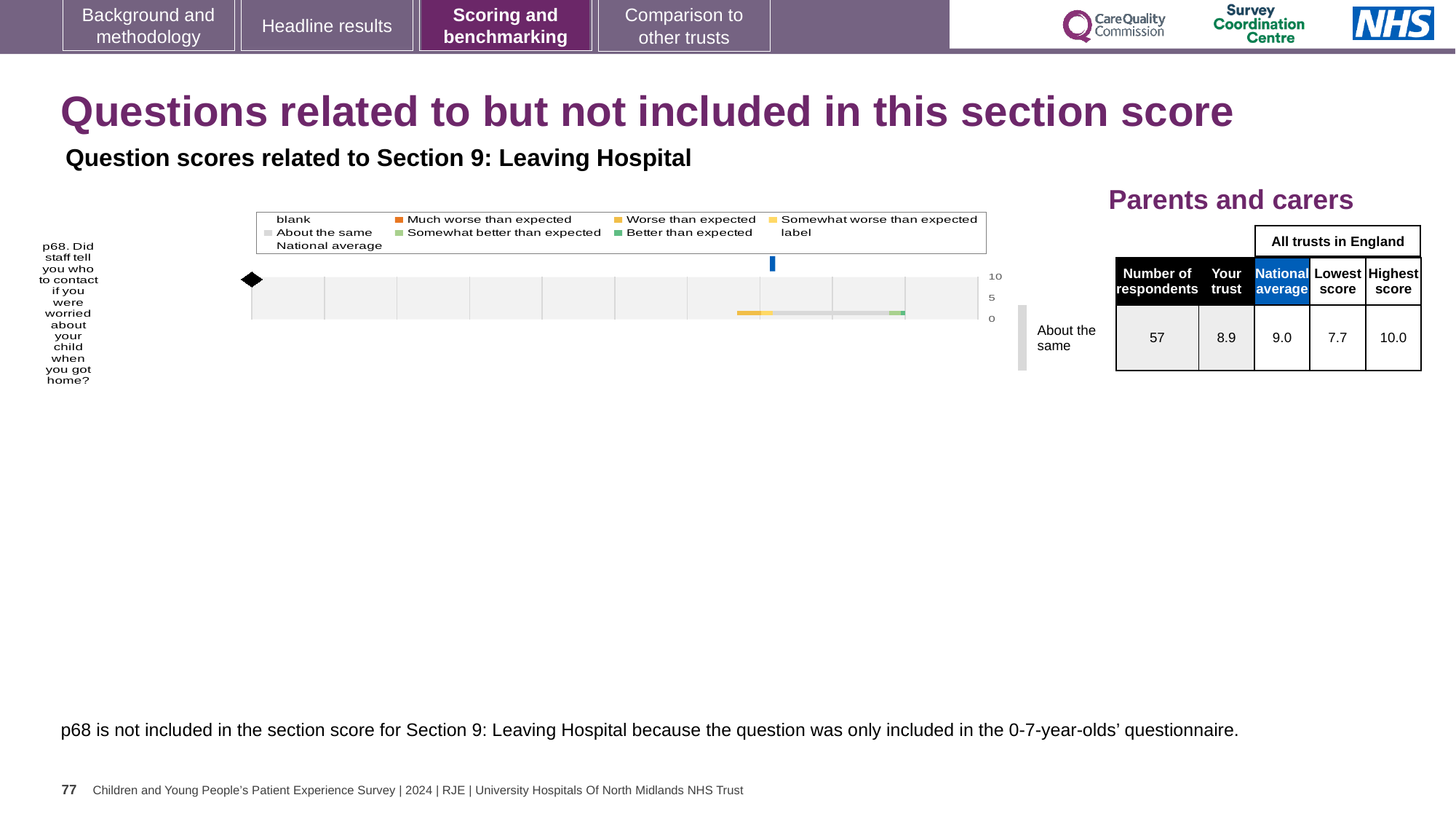
How many entries does the chart legend list? 9 In the table beside the chart, what is the highest score among all trusts in England for question p68? 10.0 What is the difference between the highest score and the lowest score for question p68 in the table? 2.3 What kind of chart is used to show the score for question p68? bar chart What rating label is shown next to the bar for question p68? About the same In the table beside the chart, how many respondents answered question p68? 57 In the table beside the chart, what is the national average score for question p68? 9.0 In the table beside the chart, what is the lowest score among all trusts in England for question p68? 7.7 How many questions are plotted in the chart? 1 In the table beside the chart, what is the 'Your trust' score for question p68? 8.9 Which question number is plotted in the chart? p68 Which is larger for question p68, the 'Your trust' score or the national average? national average